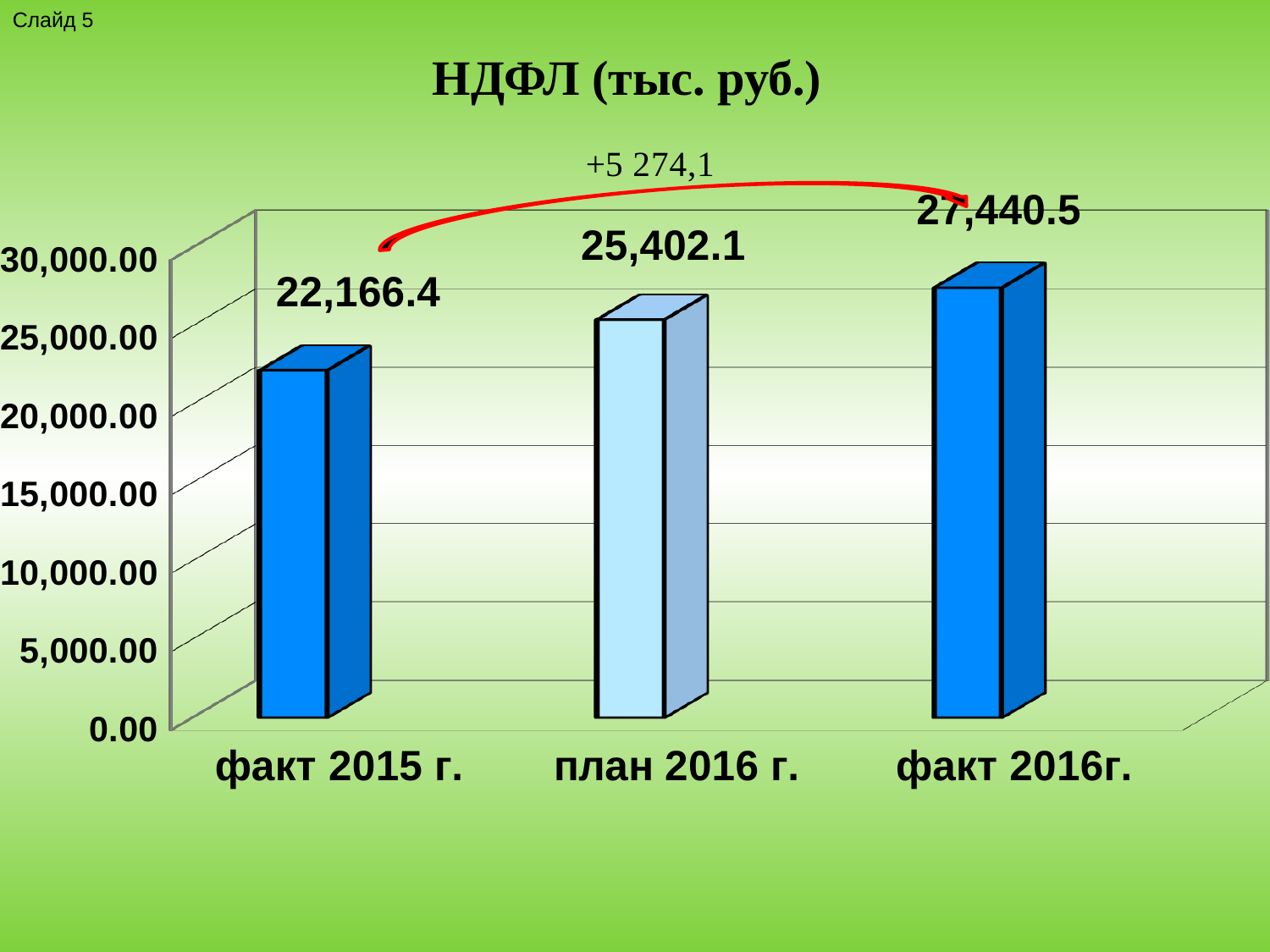
How many categories are shown on the x axis? 3 What is the value for план 2016 г.? 25,402.1 What is the difference between the values for план 2016 г. and факт 2015 г.? 3,235.7 Which category has the lowest value? факт 2015 г. What is the title of the chart? НДФЛ (тыс. руб.) What kind of chart is shown on the slide? bar chart Which is larger, the value for план 2016 г. or the value for факт 2016г.? факт 2016г. What is the difference between the values for факт 2016г. and факт 2015 г.? 5,274.1 What is the value for факт 2016г.? 27,440.5 What is the value for факт 2015 г.? 22,166.4 Which category has the highest value? факт 2016г. Is the value for план 2016 г. greater or less than 25,000.00? greater